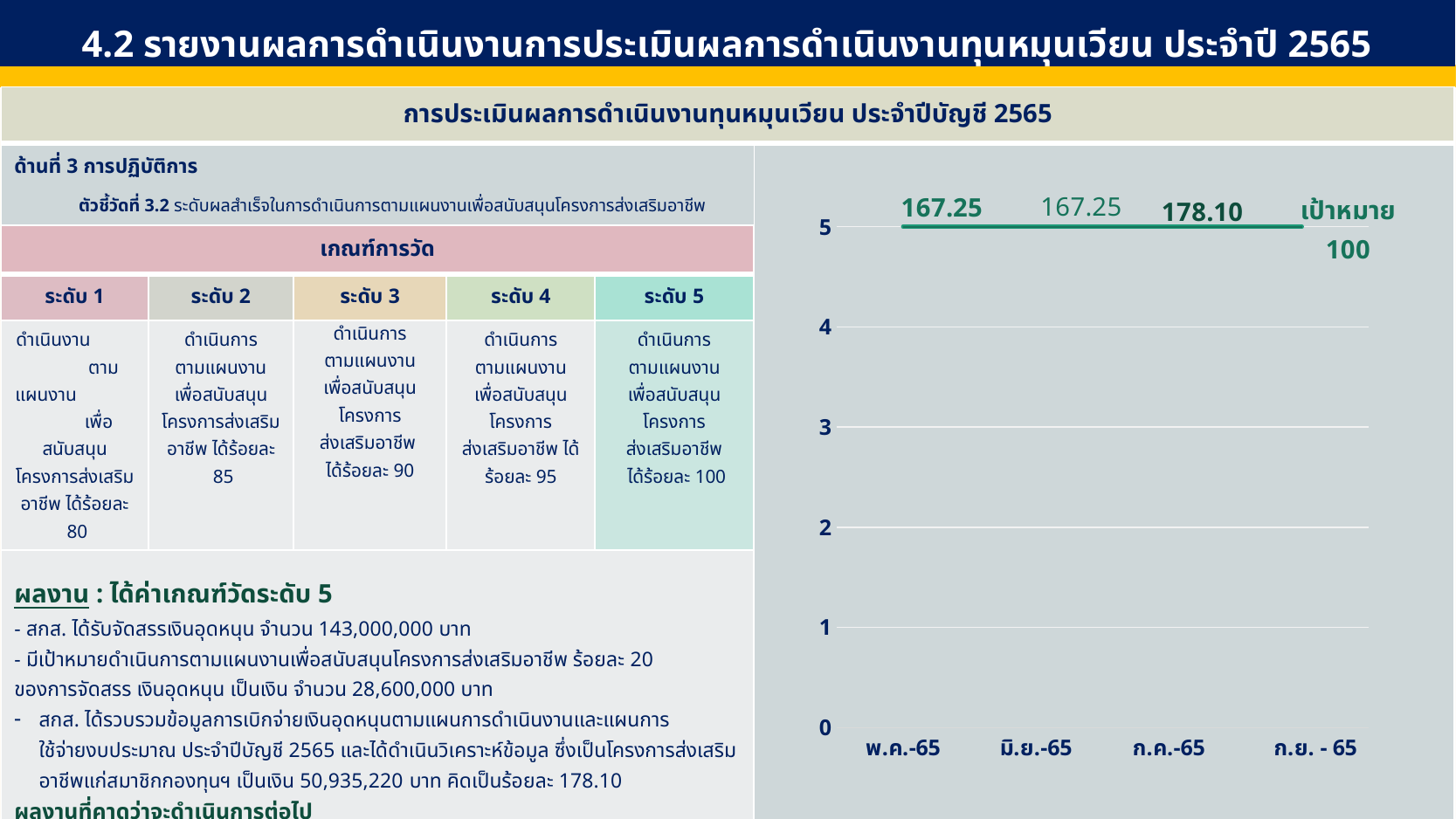
What is the target (เป้าหมาย) value shown on the chart? 100 Is the labelled value for ก.ค.-65 greater or less than 170? greater What data label is shown for พ.ค.-65 on the chart? 167.25 What is the difference between the labelled values for ก.ค.-65 and มิ.ย.-65? 10.85 Do the labelled values rise or fall from พ.ค.-65 to ก.ค.-65? rise Which labelled value is larger, ก.ค.-65 or พ.ค.-65? ก.ค.-65 How many categories are shown on the x axis of the chart? 4 Which month has the highest labelled value on the chart? ก.ค.-65 What data label is shown for มิ.ย.-65 on the chart? 167.25 What is the highest tick value on the y axis of the chart? 5 What data label is shown for ก.ค.-65 on the chart? 178.10 What kind of chart is shown on the slide? line chart